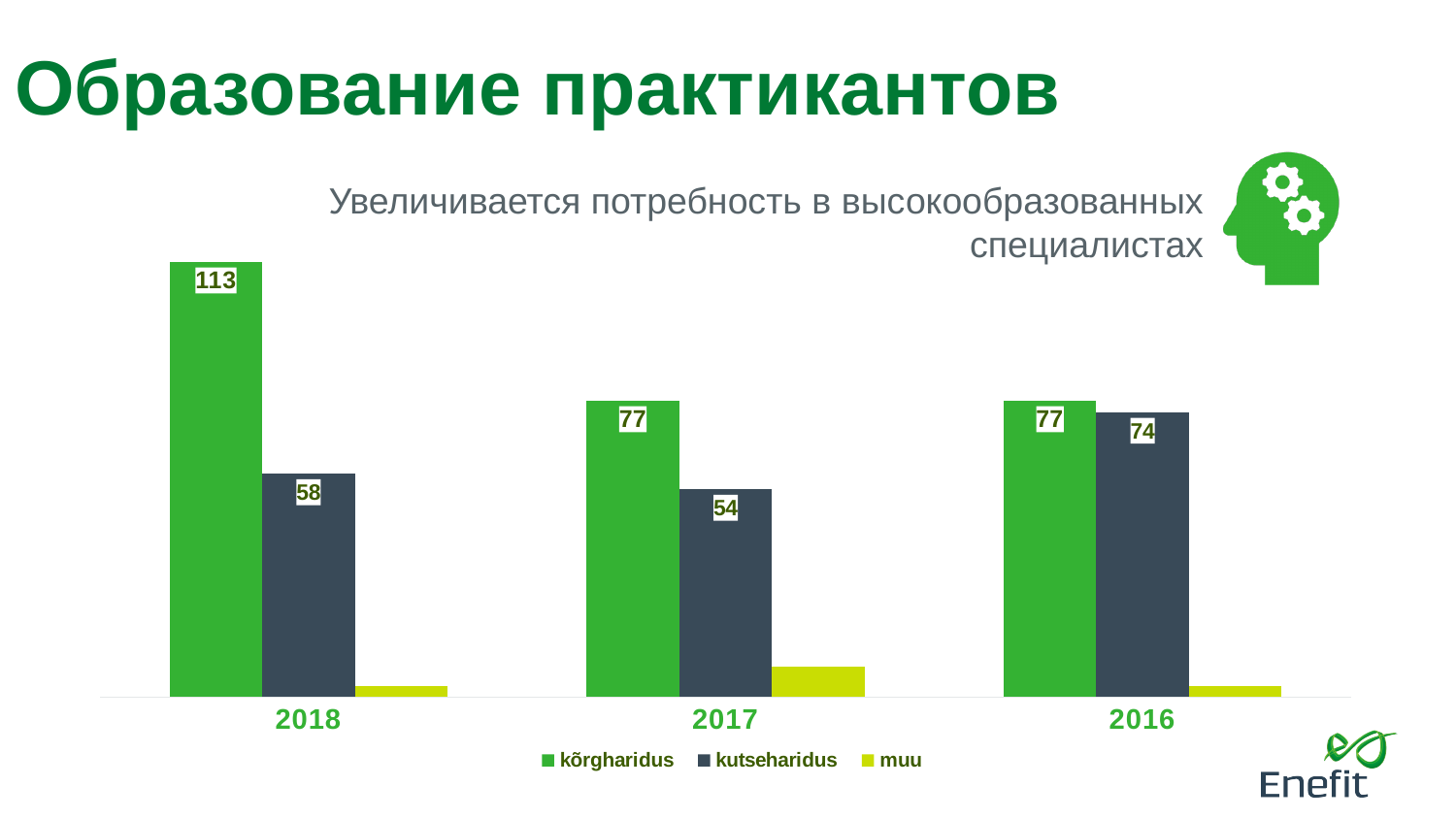
In which year is the kõrgharidus value highest? 2018 What is the value for kutseharidus in 2016? 74 Which is larger in 2016, kõrgharidus or kutseharidus? kõrgharidus What kind of chart is shown on the slide? bar chart What is the difference between the kõrgharidus and kutseharidus values in 2018? 55 Which series is shown in dark grey-blue in the legend? kutseharidus How many series does the legend list? 3 In which year is the kutseharidus value lowest? 2017 How many years are shown on the x axis? 3 What is the value for kõrgharidus in 2017? 77 What is the value for kõrgharidus in 2018? 113 What is the value for kutseharidus in 2017? 54